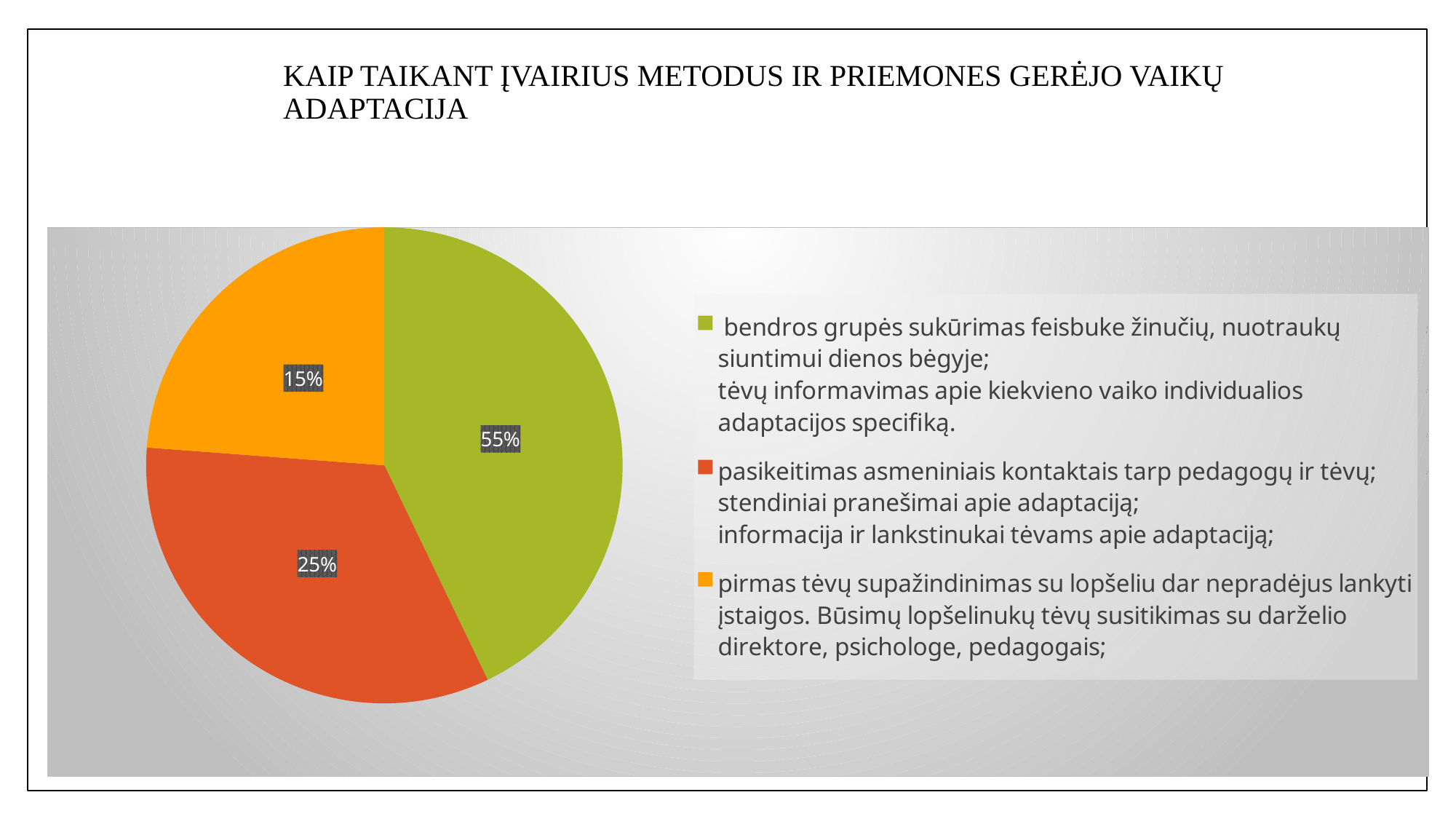
What is the difference in percentage points between the largest slice (55%) and the smallest slice (15%)? 40 Which legend entry corresponds to the largest slice of the pie chart? bendros grupės sukūrimas feisbuke žinučių, nuotraukų siuntimui dienos bėgyje; tėvų informavimas apie kiekvieno vaiko individualios adaptacijos specifiką. Which legend entry corresponds to the smallest slice of the pie chart? pirmas tėvų supažindinimas su lopšeliu dar nepradėjus lankyti įstaigos. Būsimų lopšelinukų tėvų susitikimas su darželio direktore, psichologe, pedagogais; How many entries does the legend of the pie chart list? 3 How many slices does the pie chart have? 3 Which is larger: the slice for "pasikeitimas asmeniniais kontaktais tarp pedagogų ir tėvų..." or the slice for "pirmas tėvų supažindinimas su lopšeliu..."? pasikeitimas asmeniniais kontaktais tarp pedagogų ir tėvų... What percentage is shown for the slice labelled "pirmas tėvų supažindinimas su lopšeliu dar nepradėjus lankyti įstaigos. Būsimų lopšelinukų tėvų susitikimas su darželio direktore, psichologe, pedagogais;"? 15% What percentage is shown for the slice labelled "pasikeitimas asmeniniais kontaktais tarp pedagogų ir tėvų; stendiniai pranešimai apie adaptaciją; informacija ir lankstinukai tėvams apie adaptaciją;"? 25% What kind of chart is shown on the slide? pie chart What colour is the slice labelled 55%? green What percentage is shown for the slice labelled "bendros grupės sukūrimas feisbuke žinučių, nuotraukų siuntimui dienos bėgyje; tėvų informavimas apie kiekvieno vaiko individualios adaptacijos specifiką."? 55% What is the title of the slide containing the pie chart? KAIP TAIKANT ĮVAIRIUS METODUS IR PRIEMONES GERĖJO VAIKŲ ADAPTACIJA